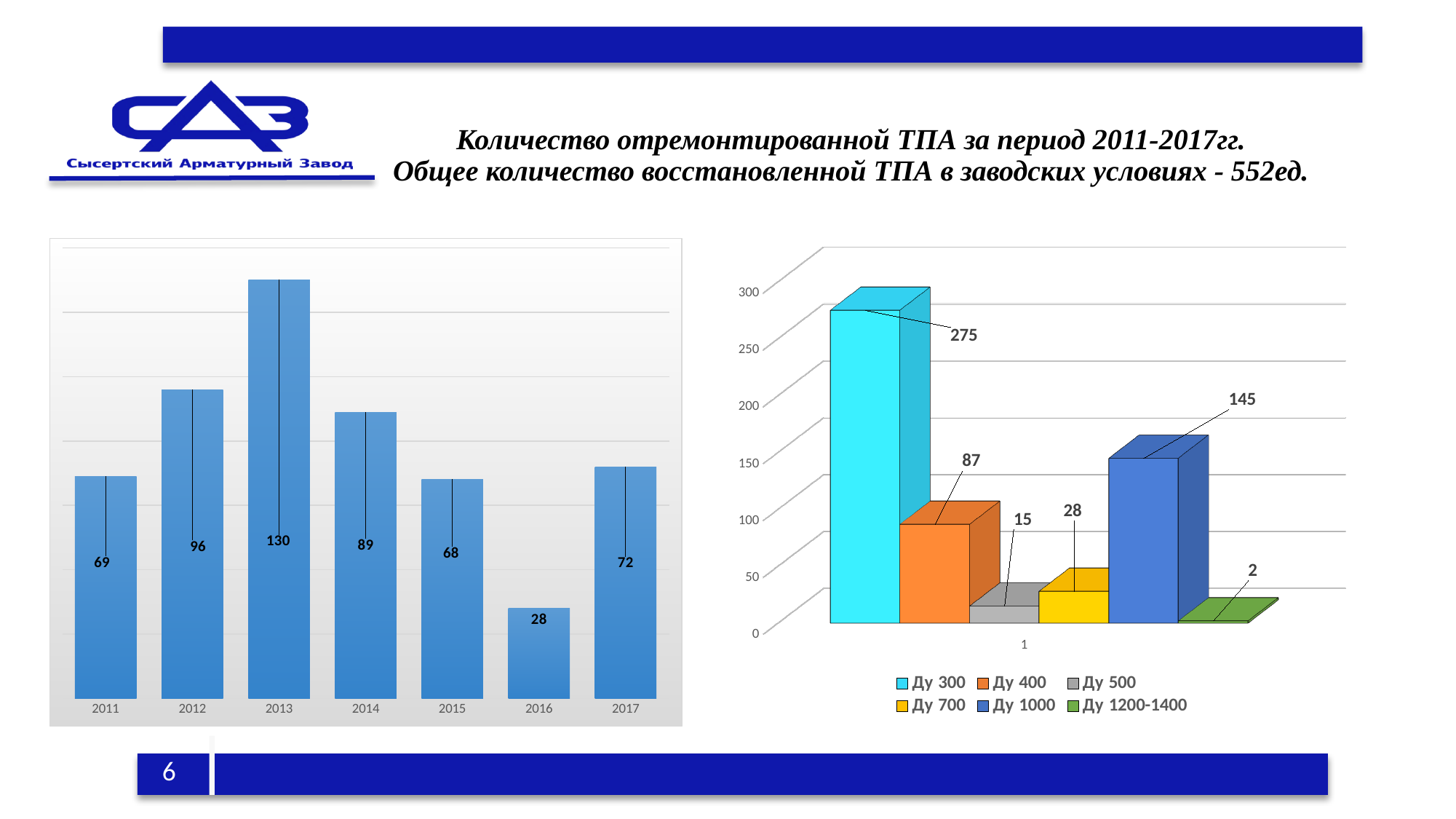
In the left chart, how many years are shown on the x axis? 7 What kind of chart is the right chart? bar chart In the right chart, what is the value for Ду 1000? 145 In the left chart, what is the value for 2016? 28 In the right chart, what is the value for Ду 400? 87 In the left chart, what is the difference between the values for 2012 and 2011? 27 In the left chart, which is larger, the value for 2014 or the value for 2017? 2014 In the left chart, which year has the lowest value? 2016 In the left chart, which year has the highest value? 2013 In the right chart, which series has the highest value? Ду 300 In the right chart, how many series does the legend list? 6 In the left chart, what is the value for 2013? 130